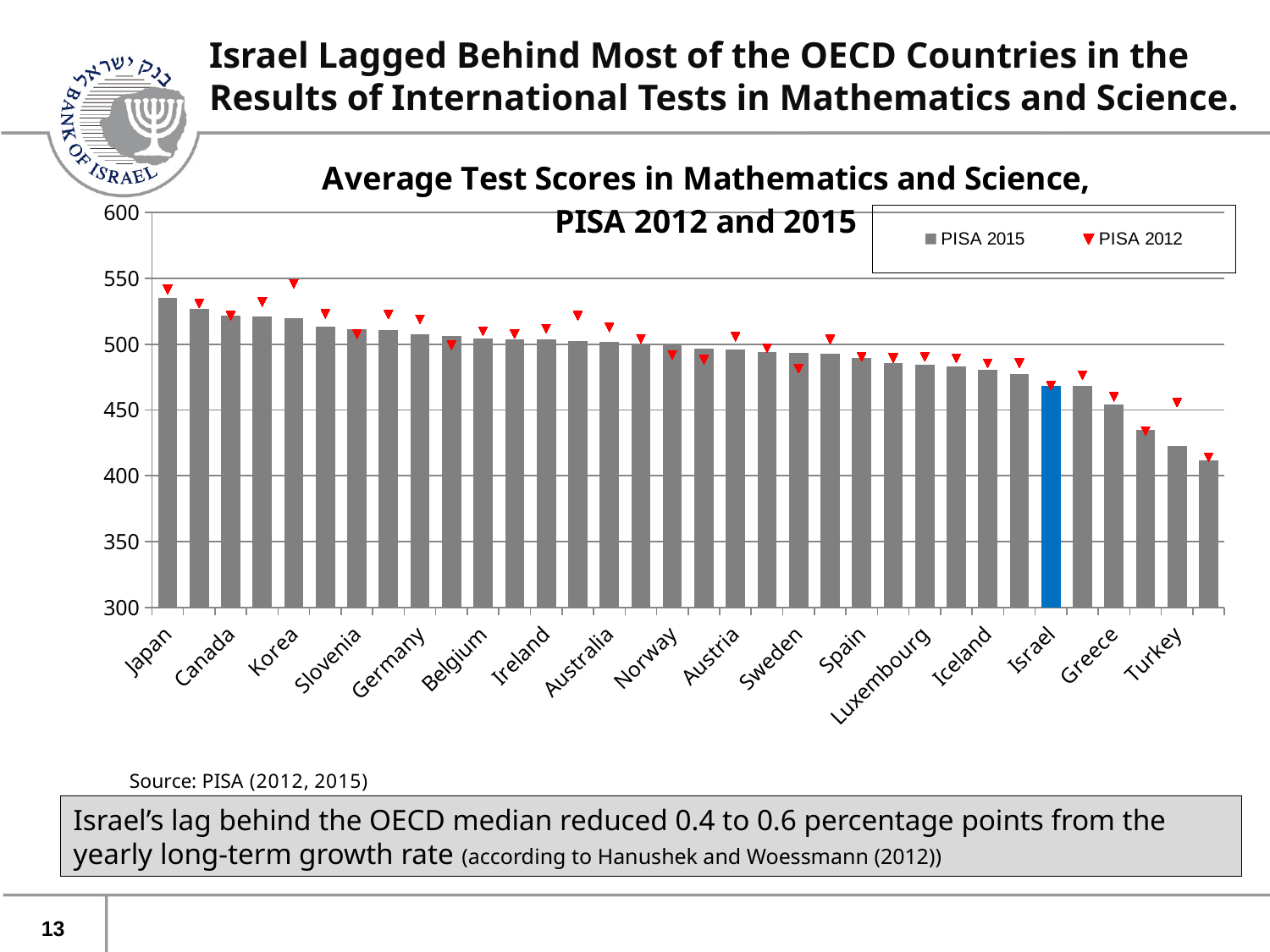
Do the PISA 2015 bars rise or fall from left to right along the x axis? fall How many series does the legend list? 2 Which has a higher PISA 2015 bar, Japan or Israel? Japan Is the PISA 2015 value for Turkey greater or less than 450? less Which country's bar is highlighted in blue? Israel Is the PISA 2015 value for Israel greater or less than 500? less What kind of chart is shown on the slide? bar chart Which has a higher PISA 2015 bar, Canada or Turkey? Canada Is the PISA 2015 value for Japan greater or less than 500? greater Which country has the highest PISA 2015 bar? Japan